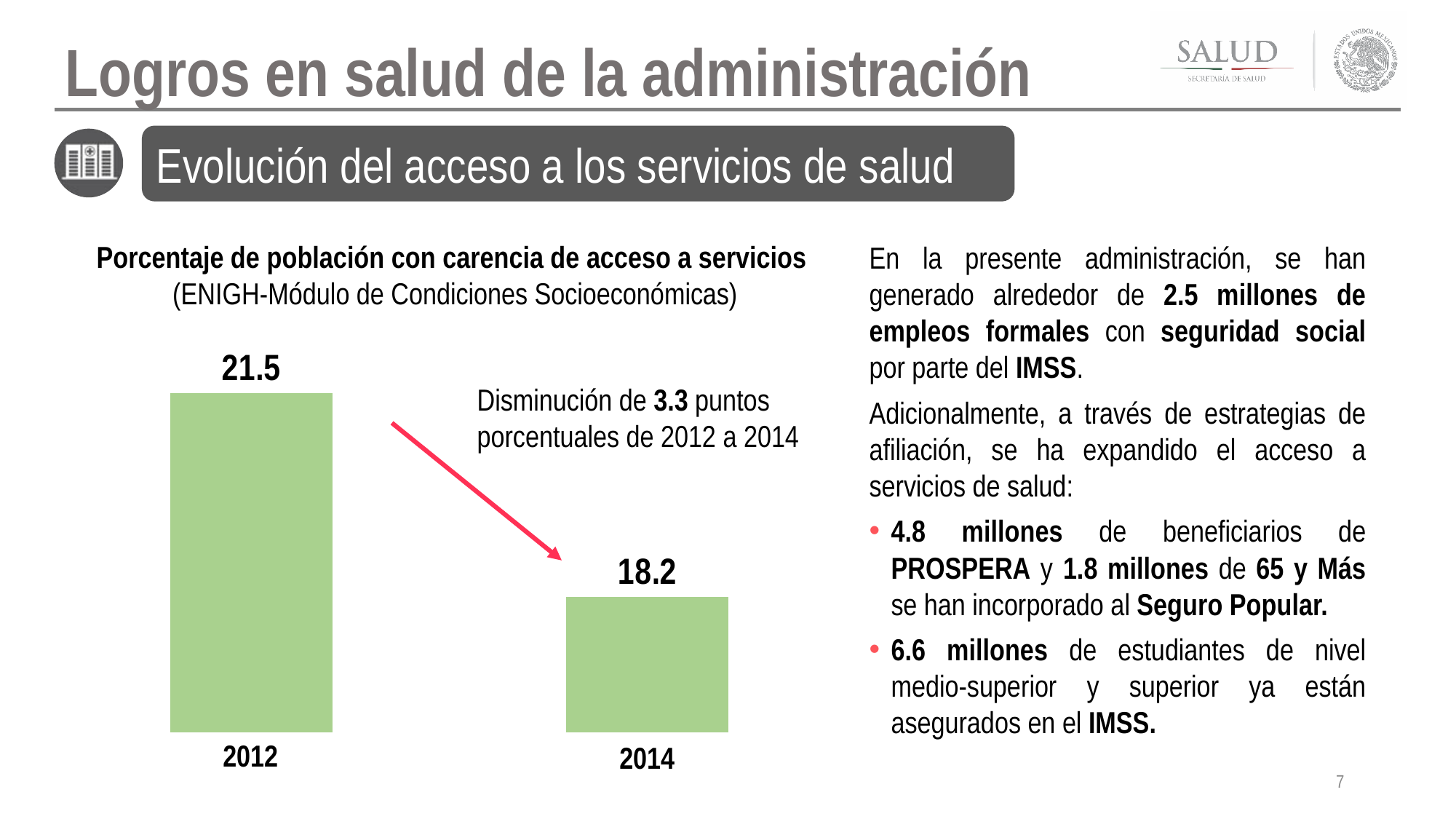
Which year has the lowest value? 2014 Which is larger, the value for 2012 or the value for 2014? 2012 What is the value for 2014? 18.2 Which year has the highest value? 2012 Do the values rise or fall from 2012 to 2014? Fall What colour are the bars in the chart? Green What kind of chart is shown on the slide? Bar chart What is the difference between the values for 2012 and 2014? 3.3 What is the value for 2012? 21.5 What is the title of the chart? Porcentaje de población con carencia de acceso a servicios How many bars are shown in the chart? 2